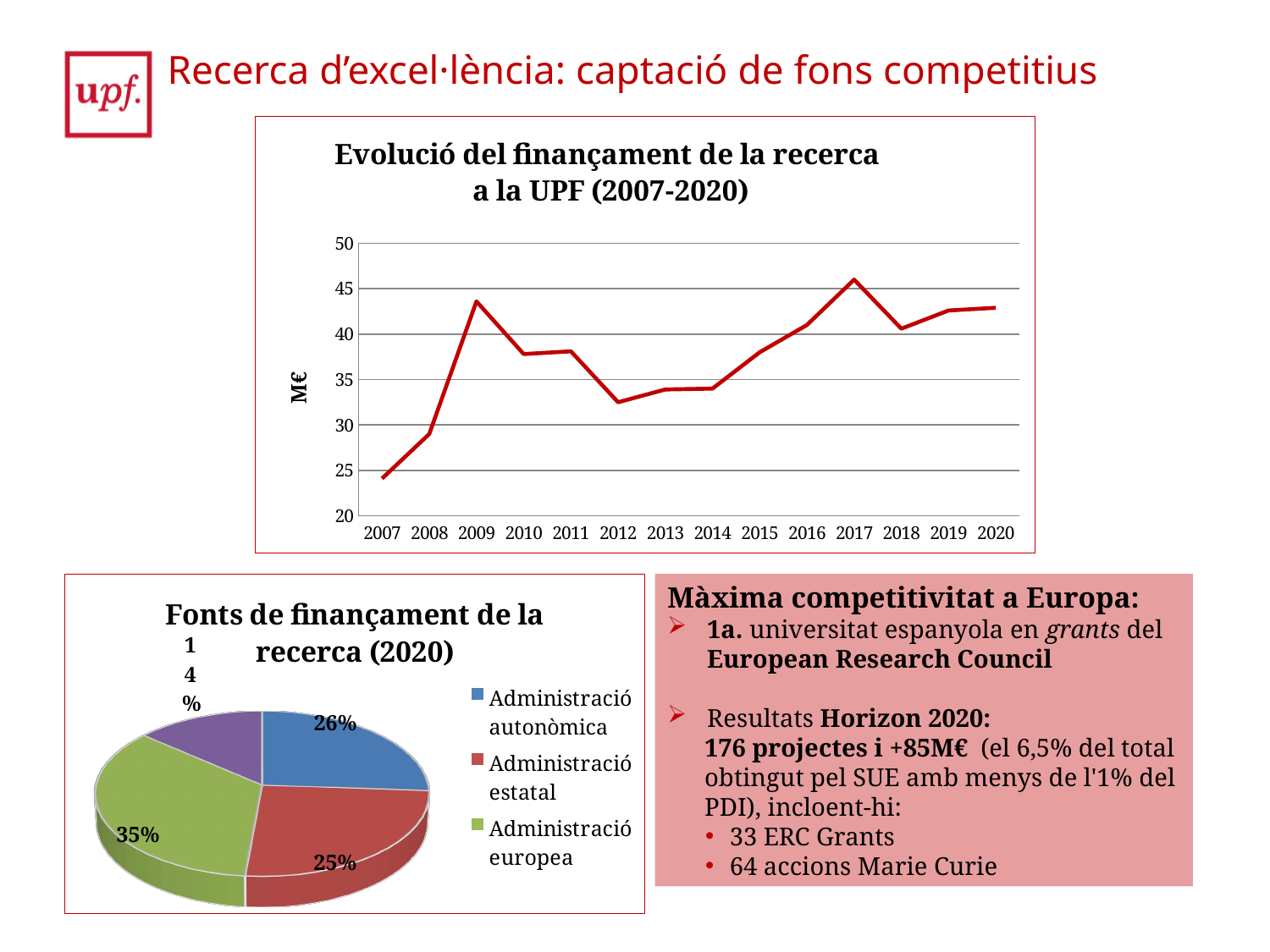
In the pie chart 'Fonts de finançament de la recerca (2020)', what share does Administració autonòmica have? 26% In the line chart 'Evolució del finançament de la recerca a la UPF (2007-2020)', which year has the highest value? 2017 In the line chart 'Evolució del finançament de la recerca a la UPF (2007-2020)', how many years are shown on the x axis? 14 In the line chart 'Evolució del finançament de la recerca a la UPF (2007-2020)', is the value for 2007 greater or less than 25? less In the line chart 'Evolució del finançament de la recerca a la UPF (2007-2020)', what is the label of the y axis? M€ In the line chart 'Evolució del finançament de la recerca a la UPF (2007-2020)', which year has the larger value, 2009 or 2012? 2009 In the line chart 'Evolució del finançament de la recerca a la UPF (2007-2020)', is the value for 2012 greater or less than 35? less In the pie chart 'Fonts de finançament de la recerca (2020)', which source has the largest share? Administració europea What type of chart is 'Evolució del finançament de la recerca a la UPF (2007-2020)'? Line chart In the line chart 'Evolució del finançament de la recerca a la UPF (2007-2020)', which year has the lowest value? 2007 In the pie chart 'Fonts de finançament de la recerca (2020)', what share does Administració europea have? 35% In the line chart 'Evolució del finançament de la recerca a la UPF (2007-2020)', is the value for 2017 greater or less than 45? greater